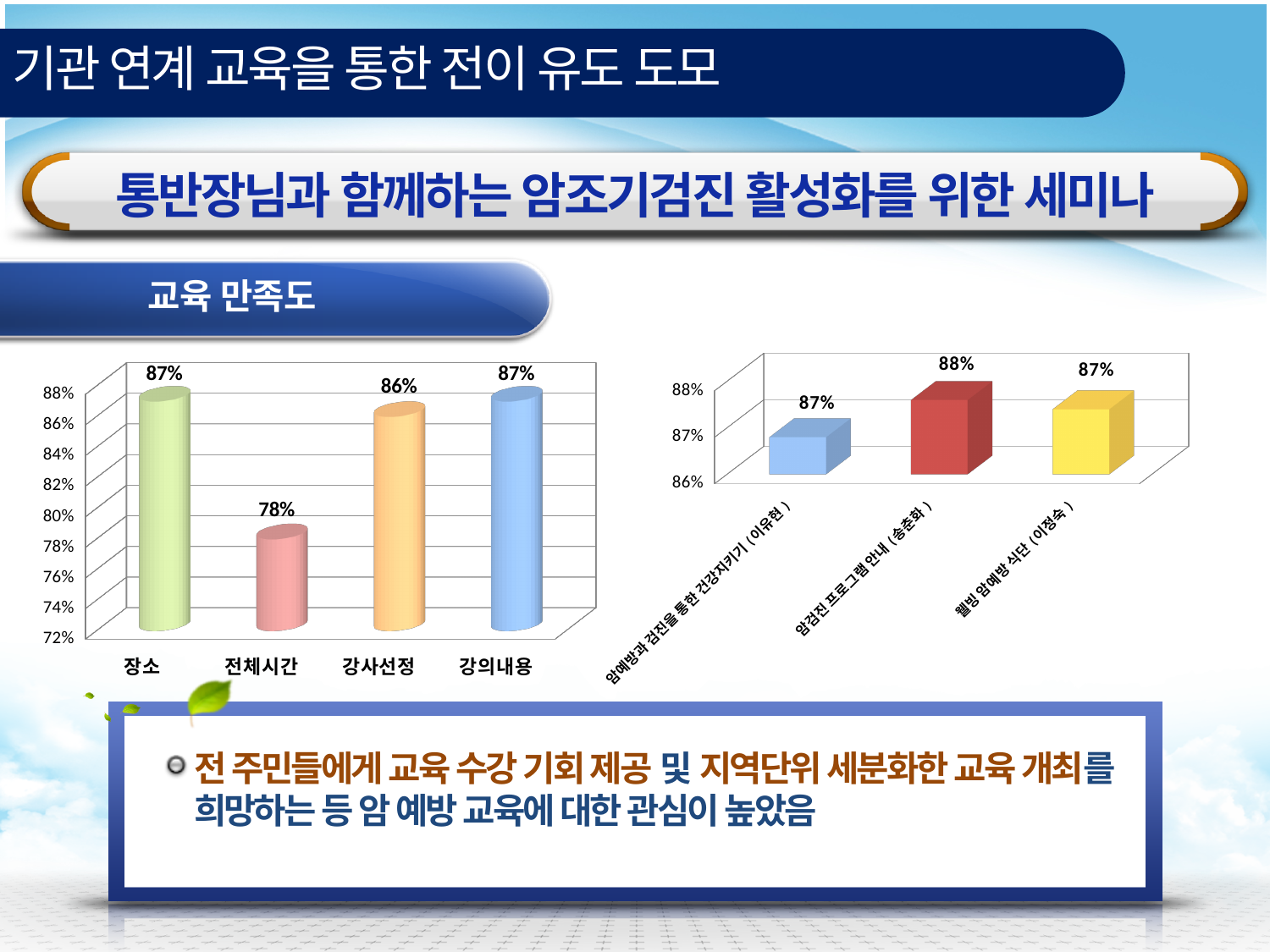
What kind of chart is the left chart? bar chart In the left chart, what is the difference between the values for 장소 and 전체시간? 9% In the right chart, what is the value for 암검진 프로그램 안내 (송춘화)? 88% In the right chart, what is the difference between the values for 암검진 프로그램 안내 (송춘화) and 웰빙 암예방 식단 (이정숙)? 1% In the left chart, which category has the lowest value? 전체시간 In the left chart, what is the value for 전체시간? 78% In the right chart, which category has the highest value? 암검진 프로그램 안내 (송춘화) In the left chart, what is the value for 장소? 87% In the left chart, how many categories are shown? 4 In the left chart, which is larger, the value for 강사선정 or the value for 전체시간? 강사선정 In the right chart, how many categories are shown? 3 In the left chart, what is the value for 강사선정? 86%